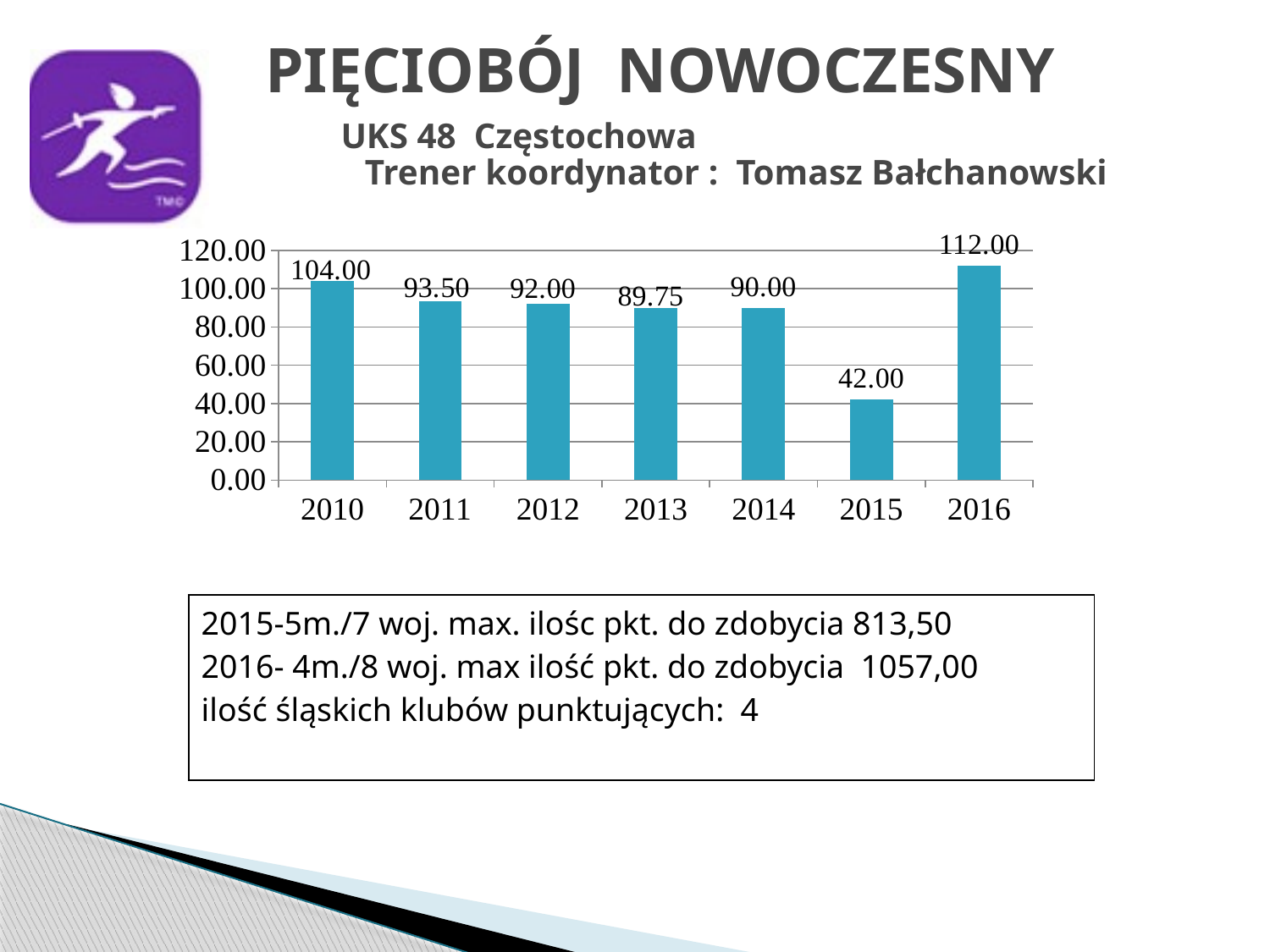
Is the value for 2011 greater or less than 80.00? greater What is the value for 2010? 104.00 Do the values rise or fall from 2010 to 2013? fall What is the difference between the values for 2016 and 2015? 70.00 Which is larger, the value for 2012 or the value for 2014? 2012 Which year has the highest value? 2016 What kind of chart is shown on the slide? bar chart How many years are shown on the x axis? 7 What is the value for 2013? 89.75 Which year has the lowest value? 2015 What is the value for 2015? 42.00 What is the difference between the values for 2010 and 2011? 10.50